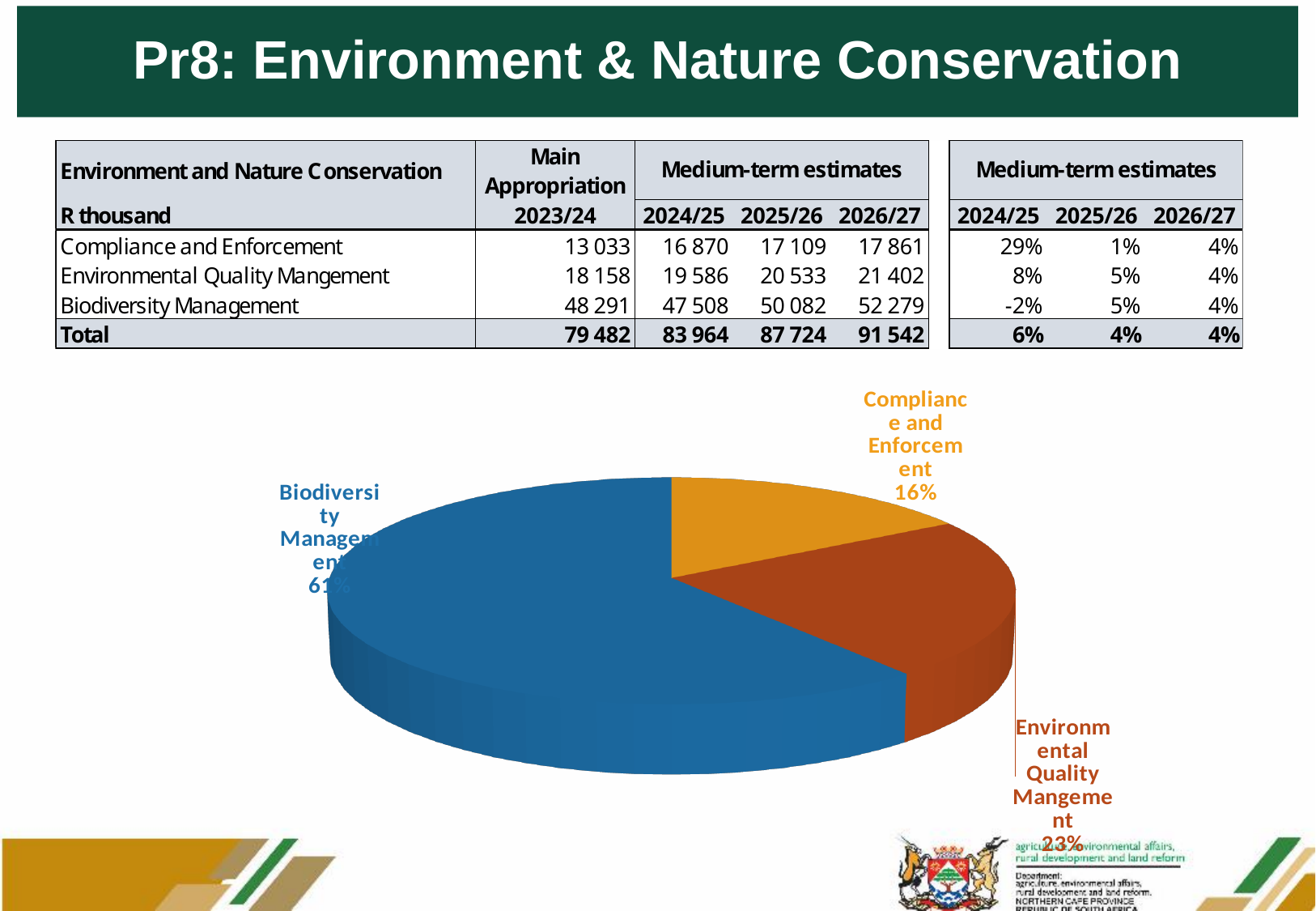
What share of the pie does Compliance and Enforcement hold? 16% What is the difference in percentage points between the Biodiversity Management slice and the Environmental Quality Mangement slice? 38 What is the difference in percentage points between the Environmental Quality Mangement slice and the Compliance and Enforcement slice? 7 What colour is the Compliance and Enforcement slice in the pie chart? yellow What share of the pie does Biodiversity Management hold? 61% What colour is the Biodiversity Management slice in the pie chart? blue What kind of chart is shown on the slide? pie chart Which is larger in the pie chart, Environmental Quality Mangement or Compliance and Enforcement? Environmental Quality Mangement What share of the pie does Environmental Quality Mangement hold? 23% Which slice of the pie chart is the smallest? Compliance and Enforcement Which slice of the pie chart is the largest? Biodiversity Management How many slices does the pie chart have? 3